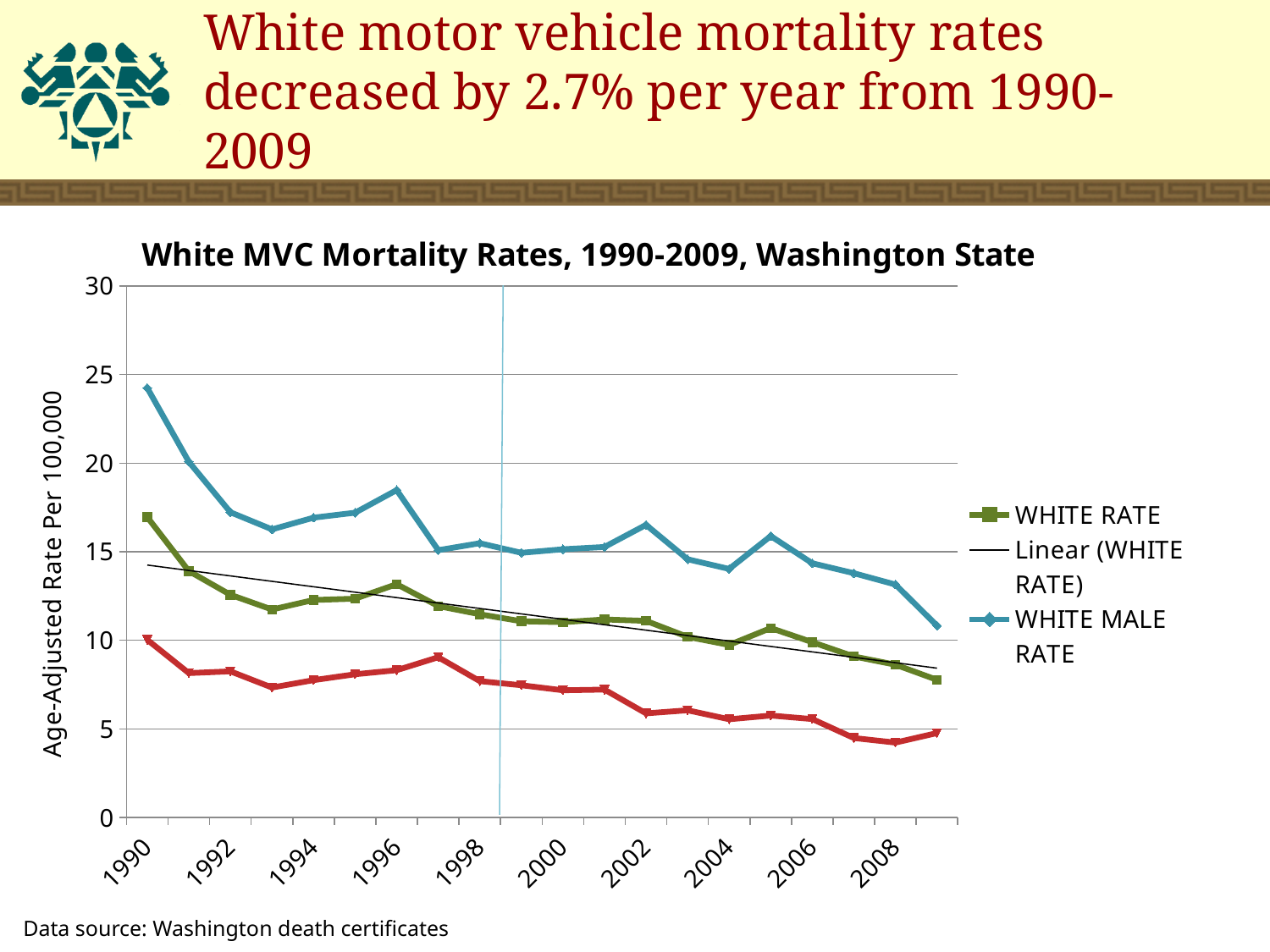
Does the WHITE RATE series rise or fall overall from 1990 to 2009? fall Is the WHITE RATE value for 1990 greater or less than 15? greater How many entries does the chart's legend list? 3 In 2000, which is larger: the WHITE MALE RATE or the WHITE RATE? WHITE MALE RATE How many years (data points) does each series cover on the chart? 20 Does the WHITE MALE RATE series rise or fall overall from 1990 to 2009? fall What is the title of the chart? White MVC Mortality Rates, 1990-2009, Washington State What kind of chart is shown on the slide? line chart What is the label on the vertical axis of the chart? Age-Adjusted Rate Per 100,000 Is the WHITE MALE RATE value for 1990 greater or less than 20? greater Is the WHITE MALE RATE value for 2009 greater or less than 15? less